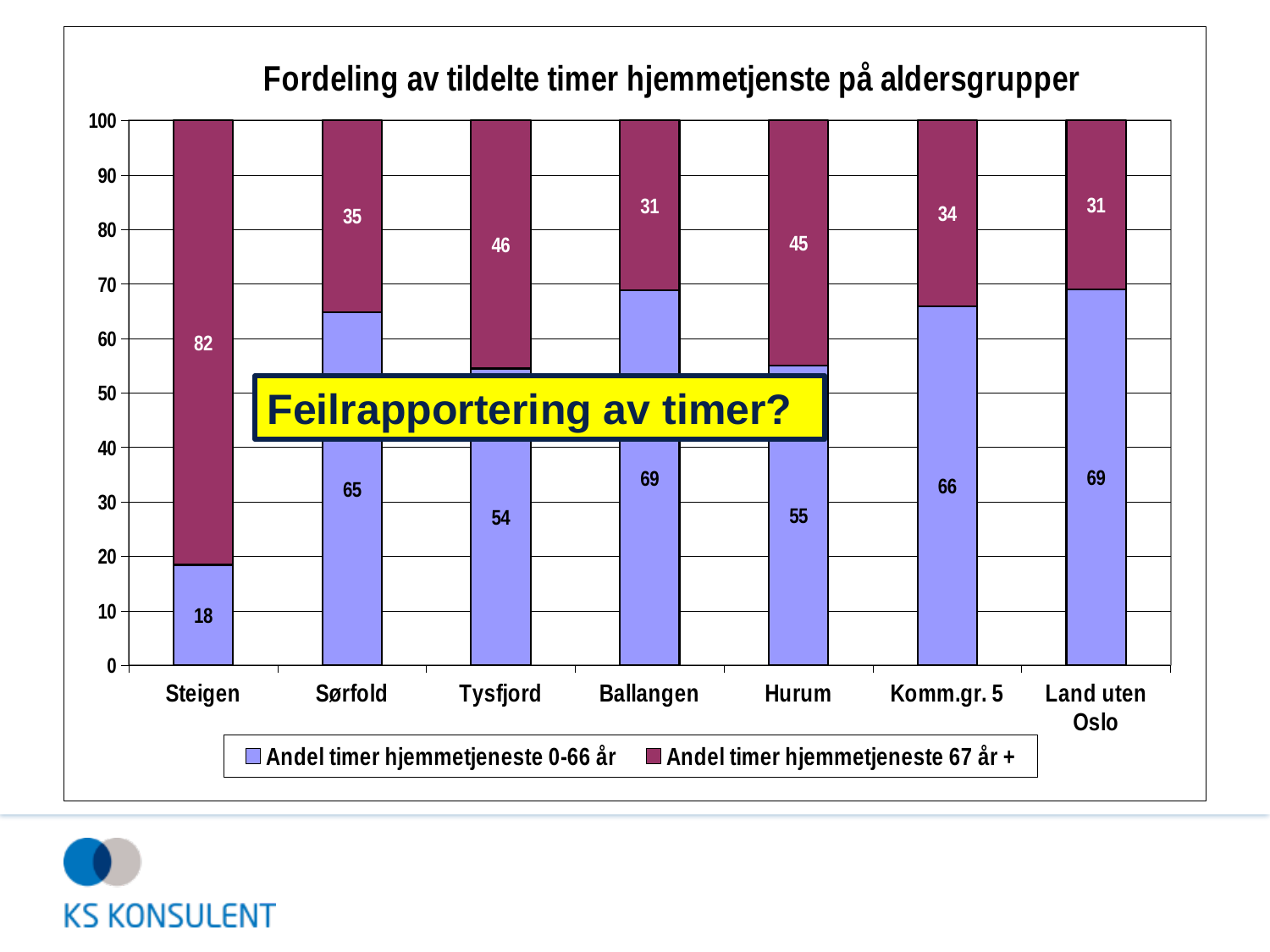
Which is larger: the 'Andel timer hjemmetjeneste 67 år +' value for Hurum or for Komm.gr. 5? Hurum What is the difference between the 'Andel timer hjemmetjeneste 0-66 år' values for Sørfold and Steigen? 47 What is the value for Tysfjord in the series 'Andel timer hjemmetjeneste 67 år +'? 46 What is the title of the chart? Fordeling av tildelte timer hjemmetjenste på aldersgrupper What is the value for Hurum in the series 'Andel timer hjemmetjeneste 0-66 år'? 55 Which category has the lowest value in the series 'Andel timer hjemmetjeneste 0-66 år'? Steigen How many categories are shown on the x axis? 7 What kind of chart is shown on the slide? Stacked bar chart Which category has the highest value in the series 'Andel timer hjemmetjeneste 67 år +'? Steigen How many series does the legend list? 2 What is the value for Steigen in the series 'Andel timer hjemmetjeneste 0-66 år'? 18 What is the total of the stacked bar for Ballangen? 100